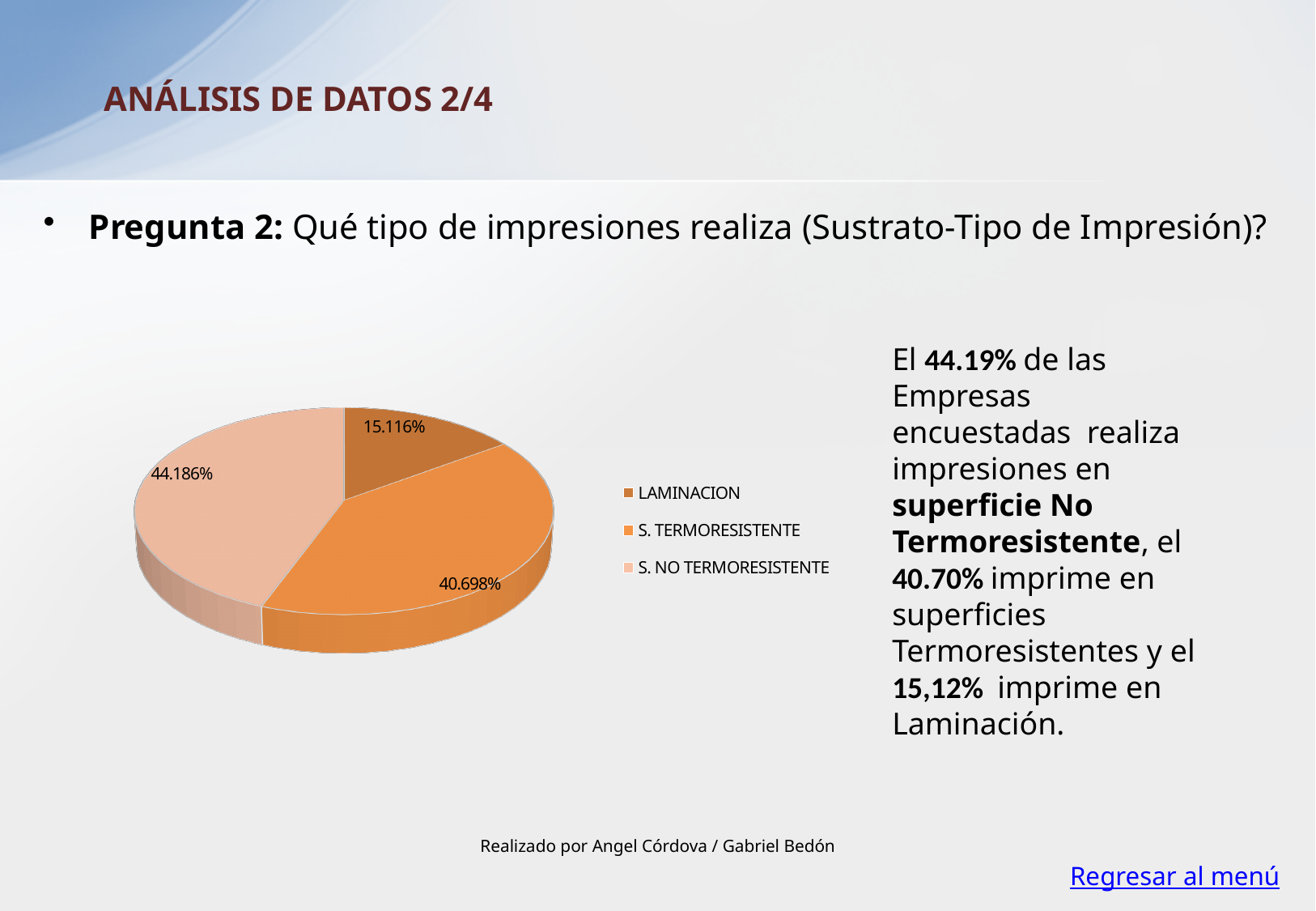
Which legend entry is shown in the lightest colour? S. NO TERMORESISTENTE Which category has the smallest slice of the pie? LAMINACION What percentage does the S. NO TERMORESISTENTE slice show? 44.186% What percentage does the LAMINACION slice show? 15.116% Which category has the largest slice of the pie? S. NO TERMORESISTENTE What kind of chart is shown on the slide? pie chart What percentage does the S. TERMORESISTENTE slice show? 40.698% Which is larger, the S. TERMORESISTENTE slice or the LAMINACION slice? S. TERMORESISTENTE What is the difference in percentage points between the S. NO TERMORESISTENTE slice and the LAMINACION slice? 29.070 How many entries does the legend list? 3 How many slices does the pie chart have? 3 What is the difference in percentage points between the S. NO TERMORESISTENTE slice and the S. TERMORESISTENTE slice? 3.488